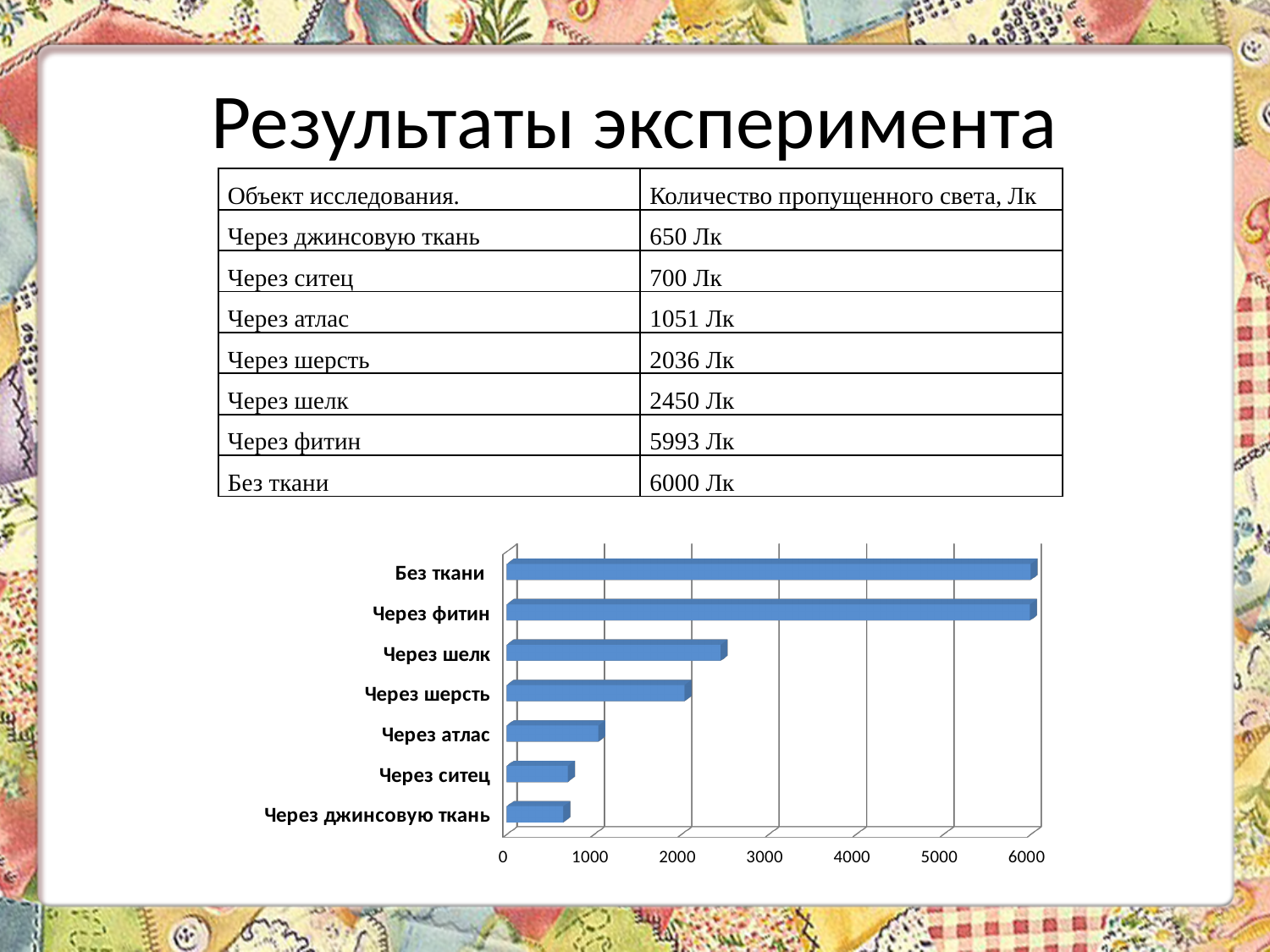
What is the difference between the values for Через шелк and Через шерсть? 414 Лк Is the value for Через ситец greater or less than 1000? less According to the slide, what is the amount of light transmitted through wool (Через шерсть)? 2036 Лк Is the value for Через фитин greater or less than 5000? greater Is the value for Через шелк greater or less than 2000? greater How many categories does the bar chart show? 7 According to the slide, what is the value for Через атлас? 1051 Лк What kind of chart is shown on the slide? bar chart What is the difference between the values for Без ткани and Через фитин? 7 Лк According to the slide, what is the value for Без ткани? 6000 Лк Which is larger, the value for Через шелк or the value for Через шерсть? Через шелк According to the slide, what is the amount of light transmitted through silk (Через шелк)? 2450 Лк